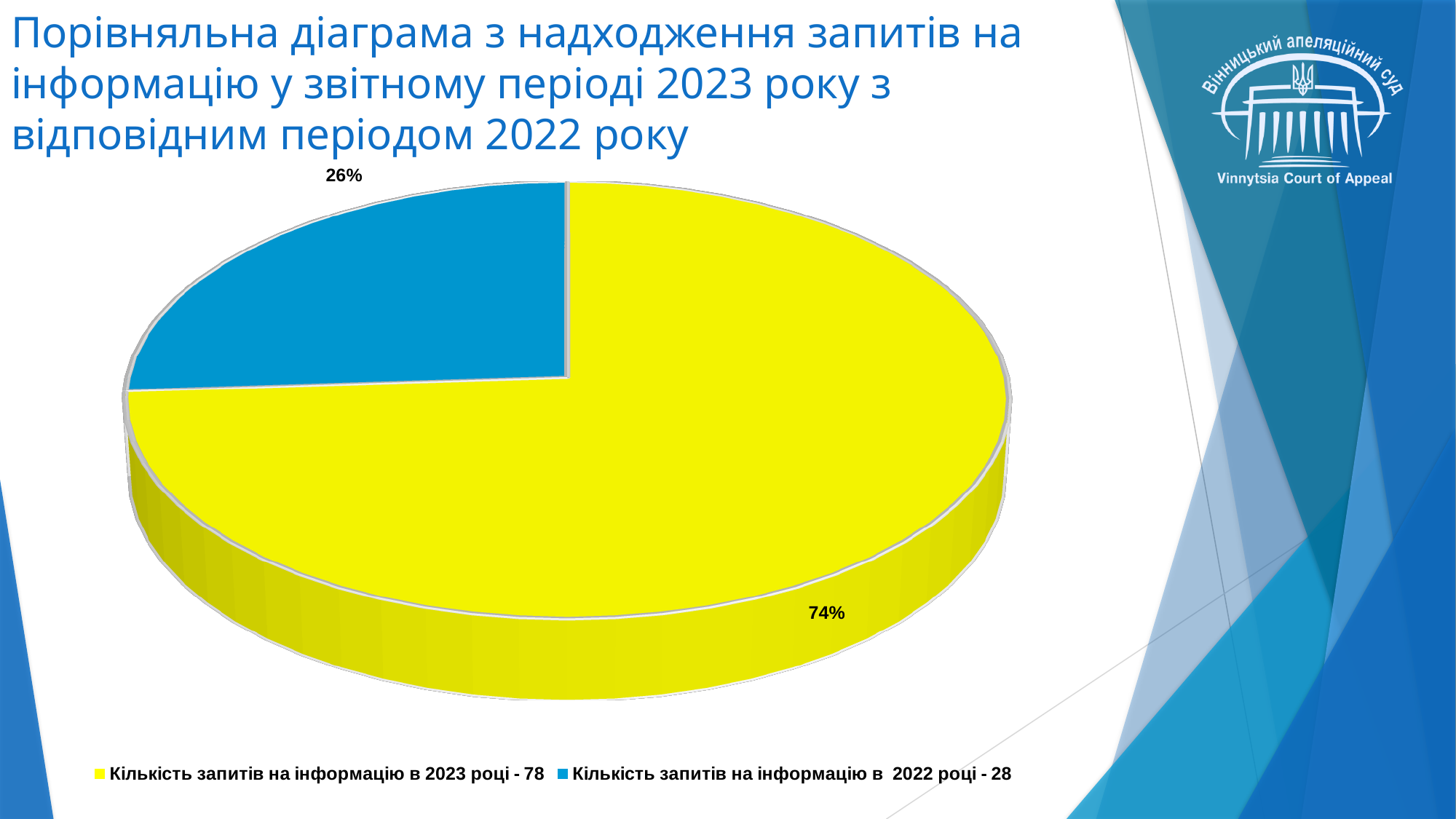
According to the legend, how many requests for information were received in 2023? 78 According to the legend, how many requests for information were received in 2022? 28 Which slice is the smallest in the pie chart? Кількість запитів на інформацію в 2022 році - 28 Which is larger: the share for 2023 or the share for 2022? 2023 How many entries does the legend list? 2 How many slices does the pie chart have? 2 What kind of chart is shown on the slide? pie chart What is the difference in percentage points between the 2023 slice and the 2022 slice? 48 What colour is the slice representing requests for information in 2022? blue Which slice is the largest in the pie chart? Кількість запитів на інформацію в 2023 році - 78 What percentage share is shown for the blue slice (requests for information in 2022)? 26% What percentage share is shown for the yellow slice (requests for information in 2023)? 74%